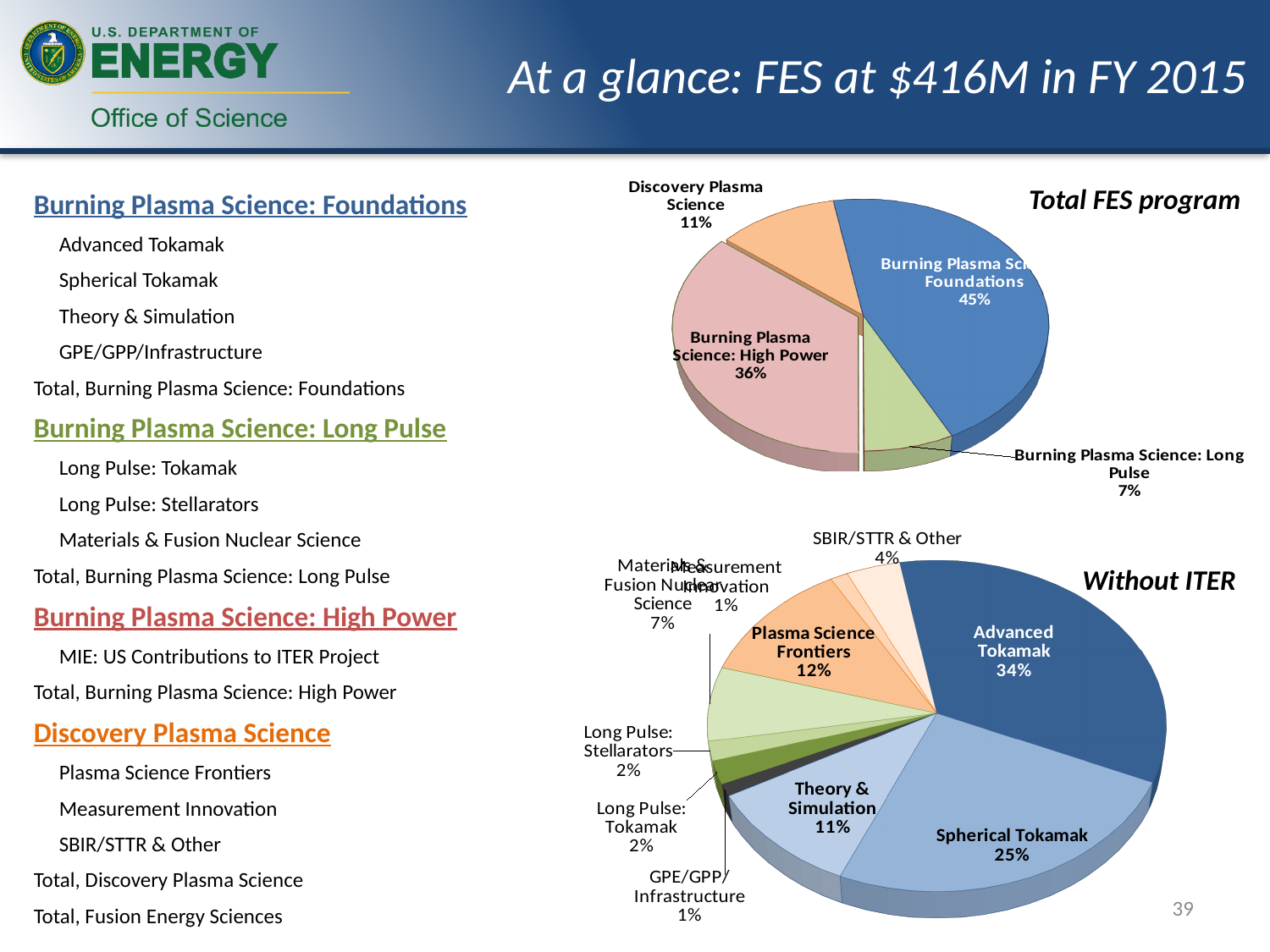
In the 'Without ITER' pie chart, what share does SBIR/STTR & Other have? 4% In the 'Total FES program' pie chart, how many slices are there? 4 In the 'Without ITER' pie chart, which is larger, Plasma Science Frontiers or Theory & Simulation? Plasma Science Frontiers In the 'Without ITER' pie chart, how many slices are there? 10 In the 'Without ITER' pie chart, which category has the largest share? Advanced Tokamak In the 'Total FES program' pie chart, which category has the smallest share? Burning Plasma Science: Long Pulse In the 'Total FES program' pie chart, what is the difference in percentage points between Burning Plasma Science: Foundations and Discovery Plasma Science? 34 percentage points In the 'Without ITER' pie chart, what is the combined share of Advanced Tokamak and Spherical Tokamak? 59% What type of chart is used for the 'Without ITER' data? Pie chart In the 'Total FES program' pie chart, what share does Burning Plasma Science: High Power have? 36% In the 'Total FES program' pie chart, what share does Burning Plasma Science: Foundations have? 45% In the 'Without ITER' pie chart, what share does Spherical Tokamak have? 25%